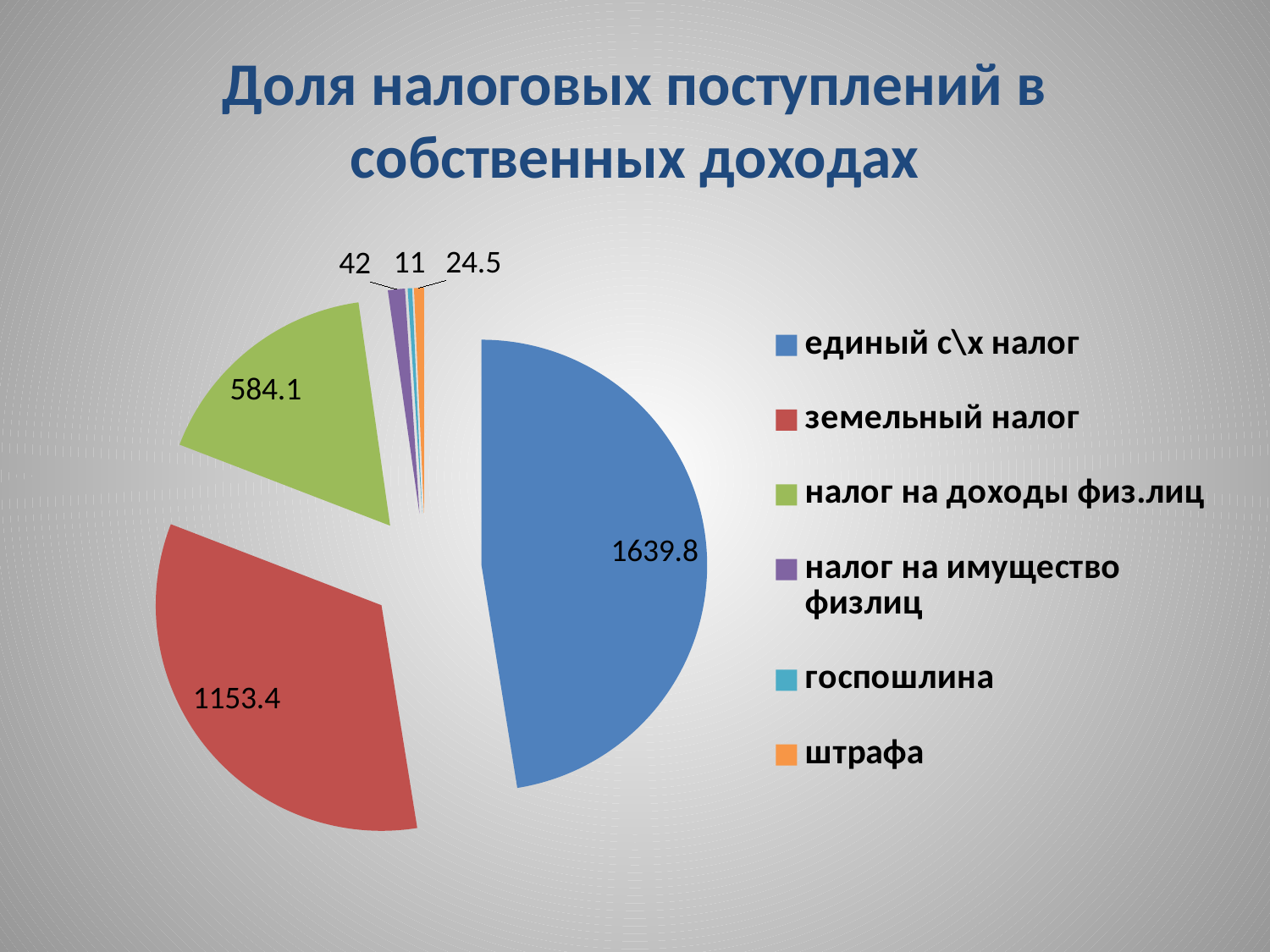
What is the value for штрафа? 24.5 Which category has the largest slice of the pie? единый с\х налог What is the title of the chart? Доля налоговых поступлений в собственных доходах Which category has the smallest slice of the pie? госпошлина What is the value for налог на доходы физ.лиц? 584.1 Which is larger, the value for налог на имущество физлиц or the value for штрафа? налог на имущество физлиц What is the value for госпошлина? 11 What is the value for единый с\х налог? 1639.8 What is the value for земельный налог? 1153.4 What is the difference between the values for единый с\х налог and земельный налог? 486.4 How many categories does the pie chart have? 6 What type of chart is shown on the slide? pie chart